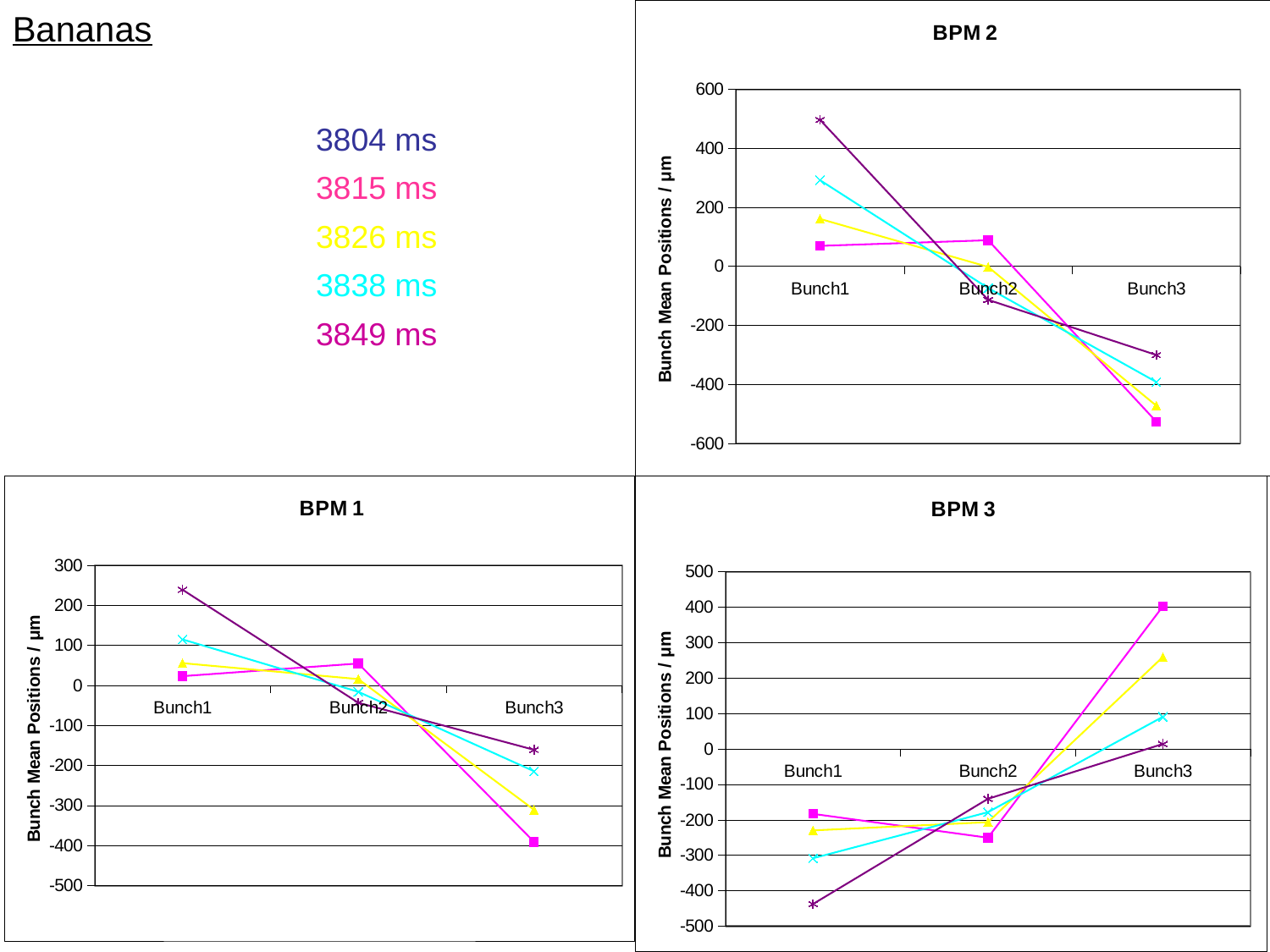
What is the y-axis title of the BPM 1 chart? Bunch Mean Positions / µm In the BPM 3 chart, is the value of the magenta square line at Bunch3 greater or less than 300? greater How many bunch categories are shown on the x axis of the BPM 1 chart? 3 In the BPM 2 chart, is the value of the dark purple asterisk line at Bunch1 greater or less than 400? greater In the BPM 1 chart, is the value of the magenta square line at Bunch3 greater or less than -300? less In the BPM 3 chart, does the yellow triangle line rise or fall from Bunch1 to Bunch3? rise In the BPM 1 chart, does the dark purple asterisk line rise or fall from Bunch1 to Bunch3? fall In the BPM 3 chart at Bunch3, which is larger: the magenta square line or the cyan x line? the magenta square line In the BPM 2 chart, at which bunch does the dark purple asterisk line reach its highest value? Bunch1 In the BPM 3 chart, at which bunch does the dark purple asterisk line have its lowest value? Bunch1 What kind of chart is the BPM 2 chart? line chart